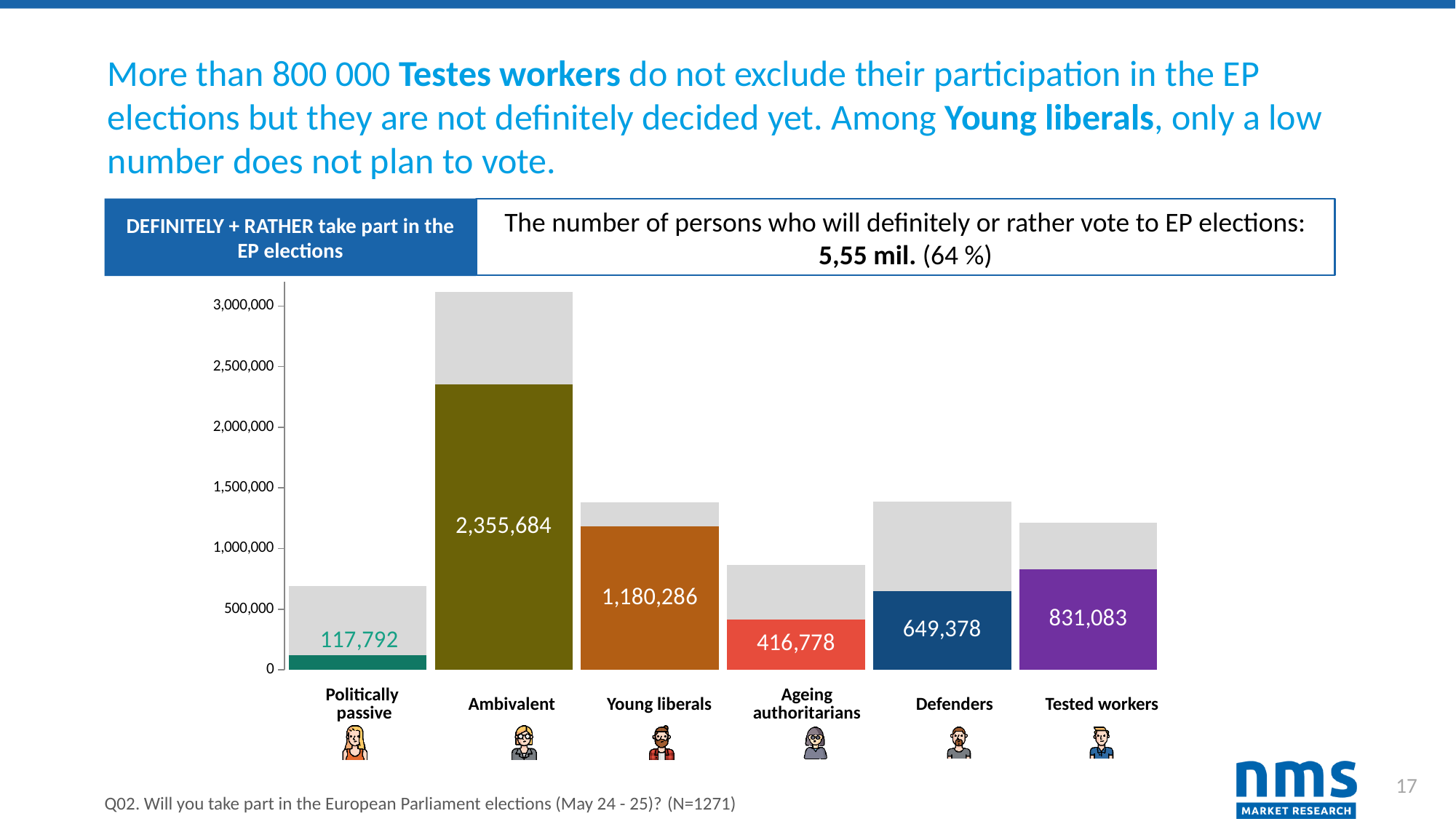
What is the number of persons who will definitely or rather vote among Ambivalent? 2,355,684 Which segment has the highest number of persons who will definitely or rather vote? Ambivalent What value is shown for Tested workers? 831,083 Which is larger, the value for Tested workers or the value for Defenders? Tested workers Is the total height of the Politically passive bar (including the grey part) greater or less than 500,000? greater What value is shown for Ageing authoritarians? 416,778 Which segment has the lowest number of persons who will definitely or rather vote? Politically passive What kind of chart is shown on the slide? Bar chart What is the difference between the values for Young liberals and Defenders? 530,908 How many segments (categories) are shown on the x axis? 6 What value is shown for Politically passive? 117,792 According to the box above the chart, what is the total number of persons who will definitely or rather vote to EP elections? 5,55 mil. (64 %)